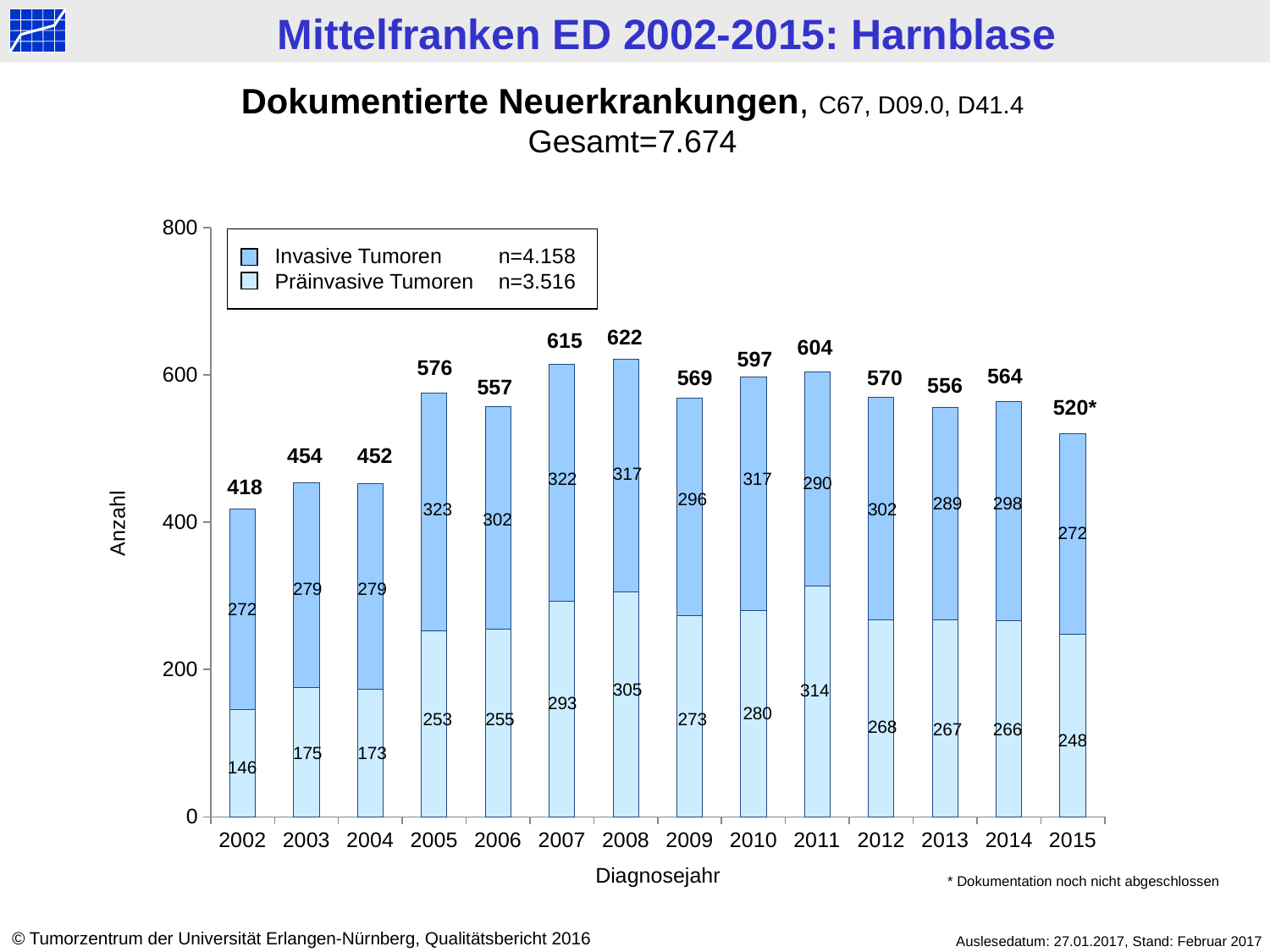
How many invasive tumours (Invasive Tumoren) are shown for 2005? 323 How many diagnosis years are shown on the x axis? 14 What is the total number of documented new cases for 2008? 622 Do the total values rise or fall from 2002 to 2005? Rise According to the legend, what is the n value for Invasive Tumoren? n=4.158 Which is larger: the number of pre-invasive tumours in 2002 or in 2003? 2003 What is the difference between the total for 2007 and the total for 2006? 58 What kind of chart is shown on the slide? Stacked bar chart How many series does the legend list? 2 Which diagnosis year has the lowest total number of cases? 2002 How many pre-invasive tumours (Präinvasive Tumoren) are shown for 2011? 314 Which diagnosis year has the highest total number of cases? 2008